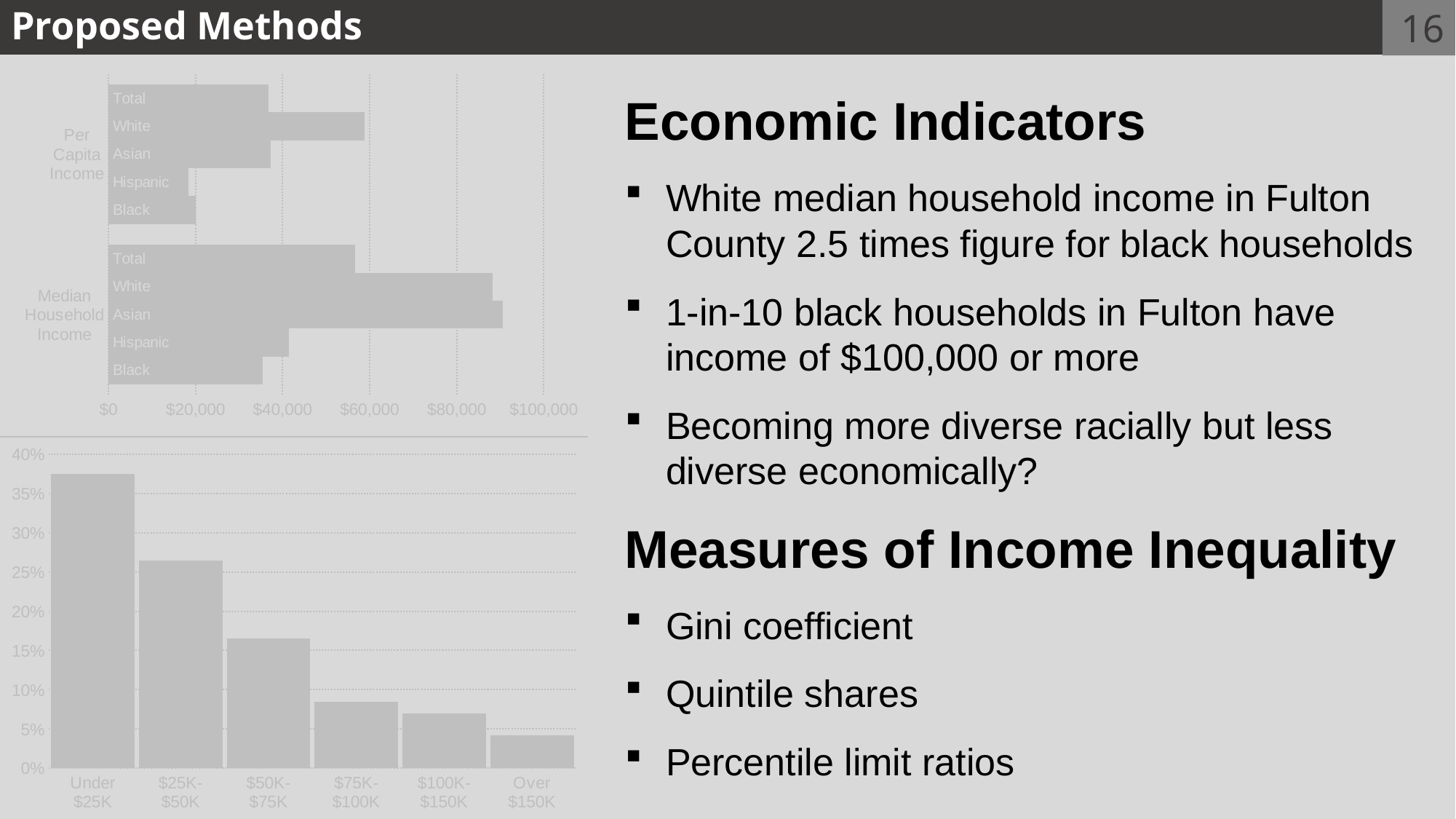
In the bottom chart, do the values rise or fall from left to right along the x axis? fall In the top chart, which is larger: the Per Capita Income for White or for Total? White What kind of chart is the top chart on the slide? bar chart In the bottom chart, which income category has the lowest value? Over $150K In the top chart, which group has the lowest Median Household Income? Black In the bottom chart, how many income categories are shown on the x axis? 6 In the top chart, is the Median Household Income for Black greater or less than $40,000? less In the bottom chart, is the value for Under $25K greater or less than 35%? greater In the bottom chart, which income category has the highest value? Under $25K In the top chart, which group has the highest Per Capita Income? White What kind of chart is the bottom chart on the slide? bar chart In the top chart, is the Per Capita Income for White greater or less than $40,000? greater